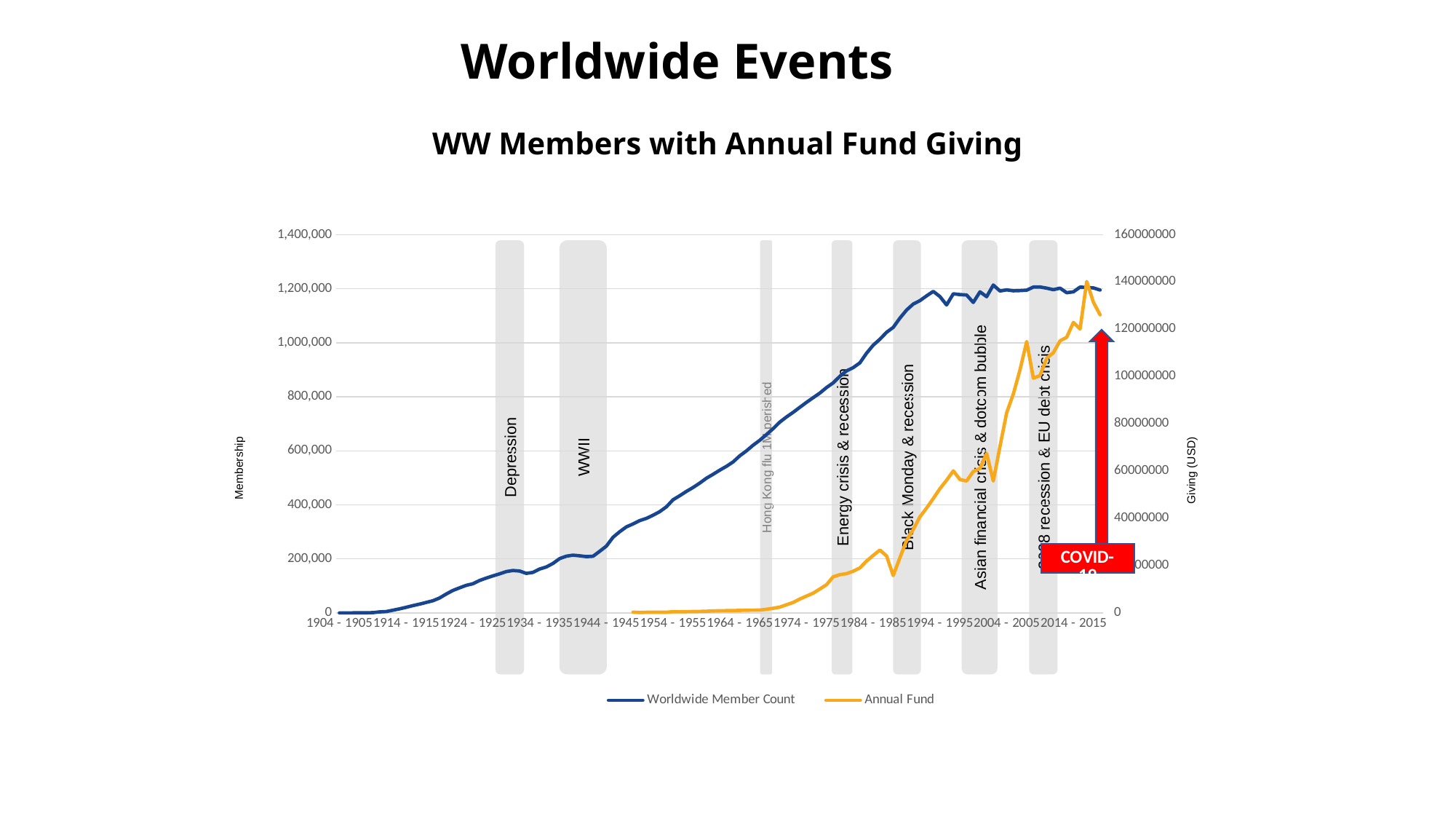
Is the Worldwide Member Count for 2014 - 2015 greater or less than 1,000,000? greater Is the Worldwide Member Count for 1964 - 1965 greater or less than 400,000? greater Is the Annual Fund value for 1984 - 1985 greater or less than 40000000? less What kind of chart is shown on the slide? line chart Which series is drawn in orange? Annual Fund Does the Worldwide Member Count generally rise or fall from 1904 - 1905 to 2014 - 2015? rise Does the Annual Fund generally rise or fall from 1954 - 1955 to 2014 - 2015? rise What is the title of the chart? WW Members with Annual Fund Giving How many series does the legend list? 2